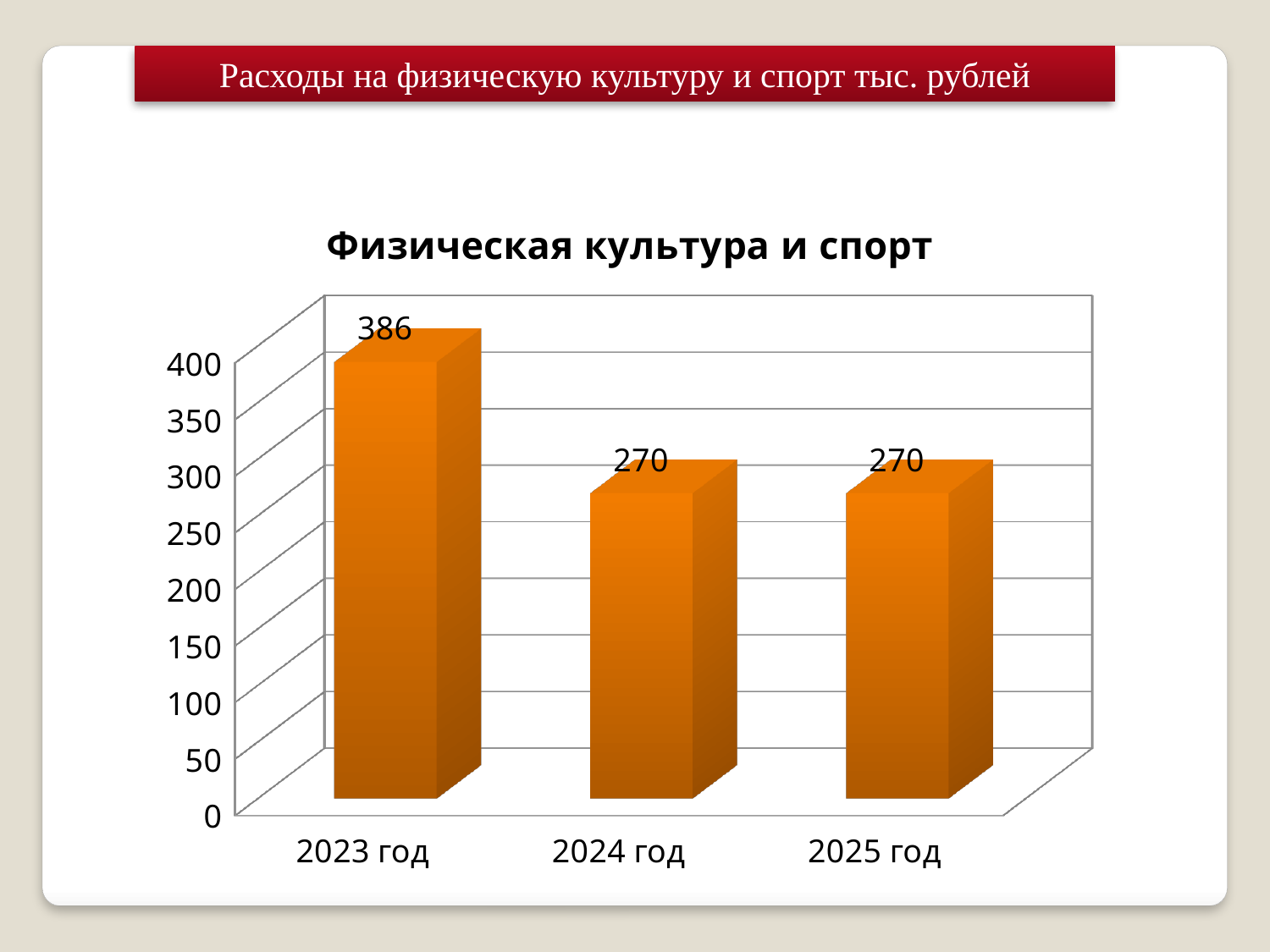
What is the value for 2025 год? 270 What is the title of the chart? Физическая культура и спорт Is the value for 2024 год greater or less than 300? less Which is larger, the value for 2023 год or the value for 2025 год? 2023 год Do the values rise or fall from 2023 год to 2024 год? fall Is the value for 2023 год greater or less than 350? greater What is the value for 2023 год? 386 Which year has the highest value? 2023 год How many categories are shown on the x axis? 3 What kind of chart is shown on the slide? bar chart What is the difference between the values for 2023 год and 2024 год? 116 What is the value for 2024 год? 270